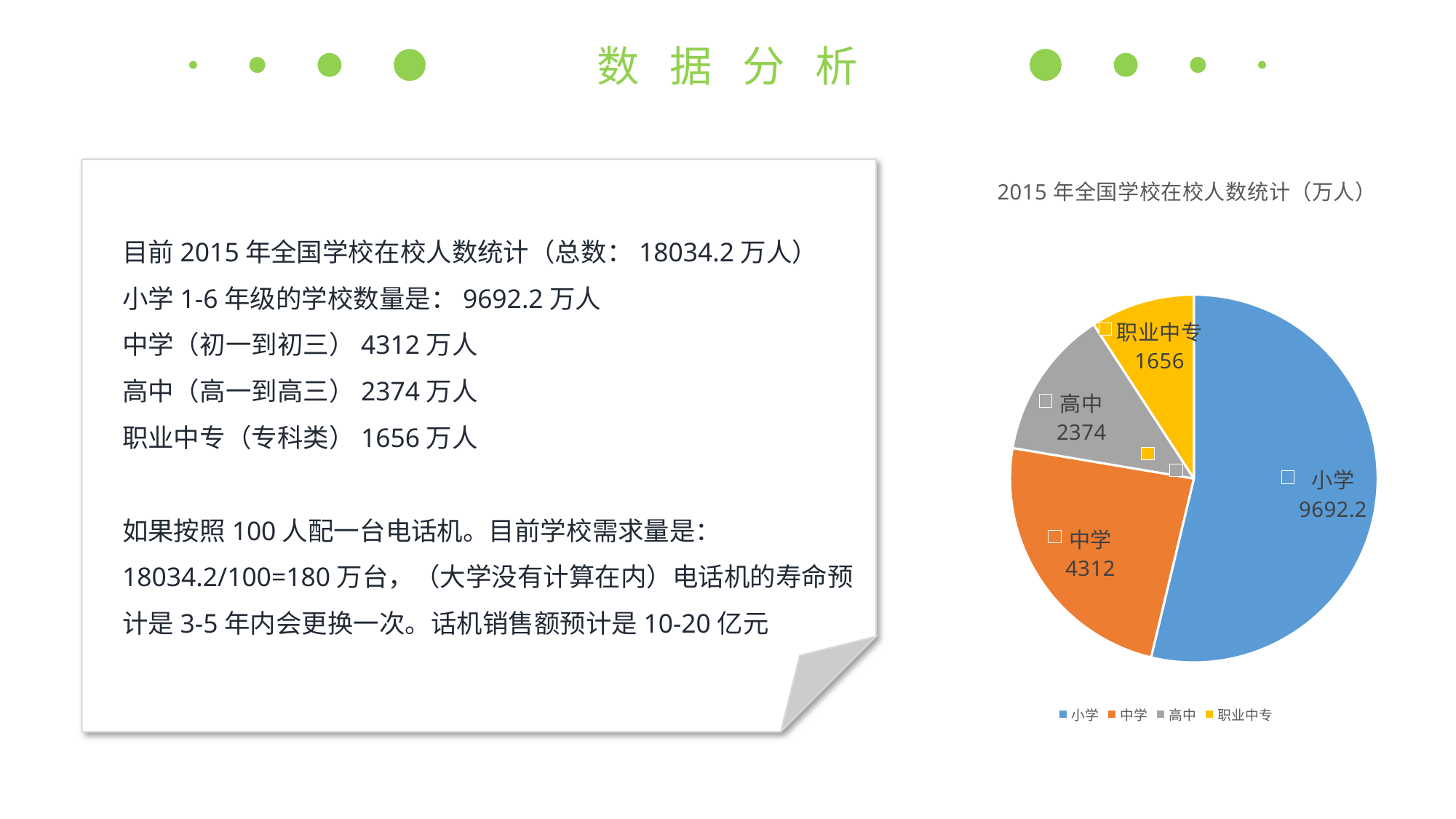
What is the total of all slices in the pie chart? 18034.2 How many slices does the pie chart have? 4 What is the value shown for 职业中专 in the pie chart? 1656 Which category has the largest slice in the pie chart? 小学 What is the title of the pie chart? 2015 年全国学校在校人数统计（万人） What kind of chart is shown on the slide? Pie chart How many entries does the legend of the pie chart list? 4 What is the value shown for 小学 in the pie chart? 9692.2 What is the value shown for 中学 in the pie chart? 4312 Which is larger in the pie chart, 高中 or 职业中专? 高中 Which category has the smallest slice in the pie chart? 职业中专 What is the difference between the values for 小学 and 中学 in the pie chart? 5380.2